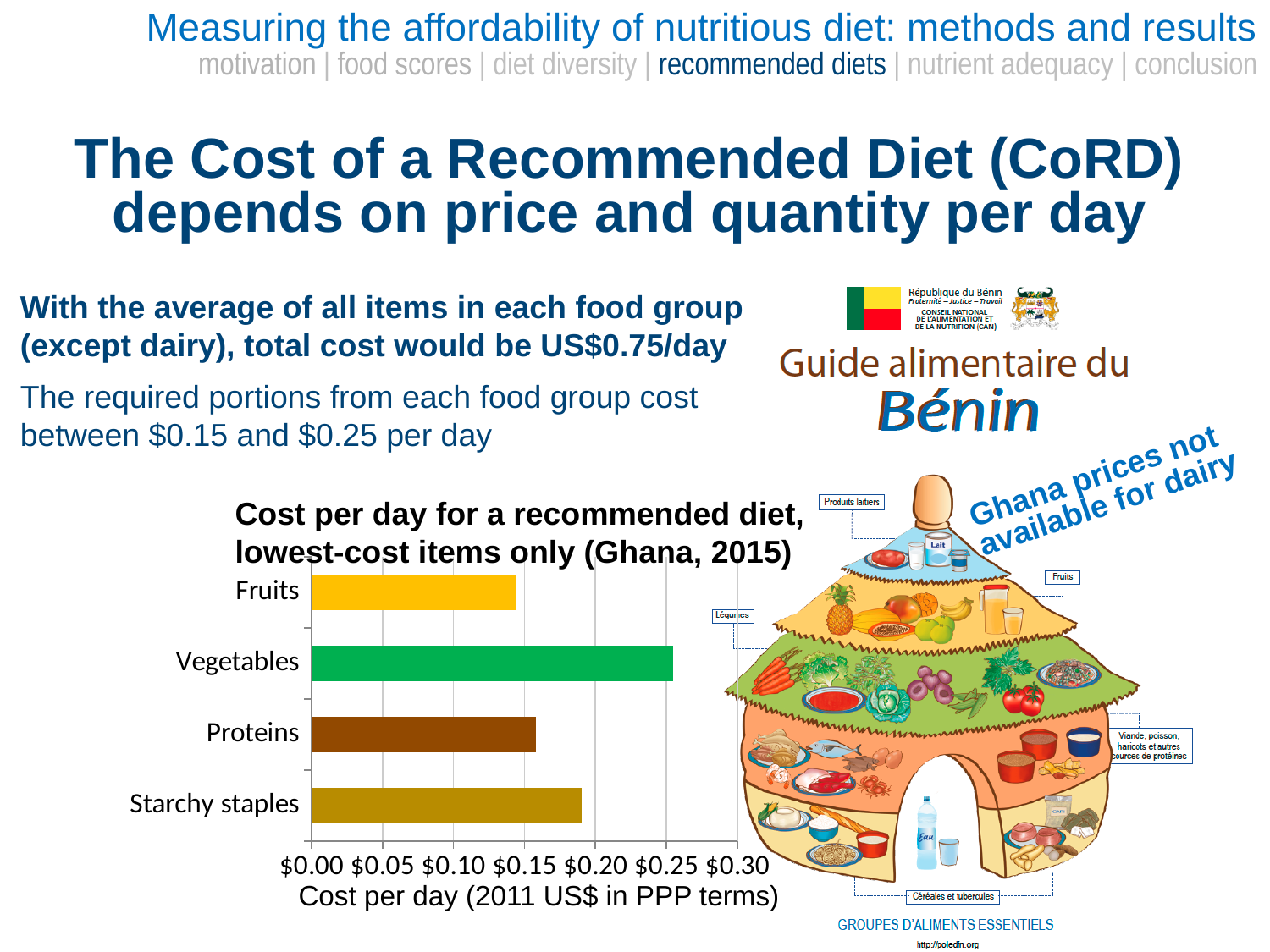
How many food groups are plotted in the chart? 4 What kind of chart is shown on the slide? bar chart Which food group has the highest cost per day in the chart? Vegetables Is the cost per day for Starchy staples greater or less than $0.15? greater Is the cost per day for Proteins greater or less than $0.20? less Which has a higher cost per day, Vegetables or Proteins? Vegetables Which has a higher cost per day, Starchy staples or Fruits? Starchy staples What is the title of the chart? Cost per day for a recommended diet, lowest-cost items only (Ghana, 2015) Is the cost per day for Vegetables greater or less than $0.20? greater What is the title of the chart's horizontal axis? Cost per day (2011 US$ in PPP terms)